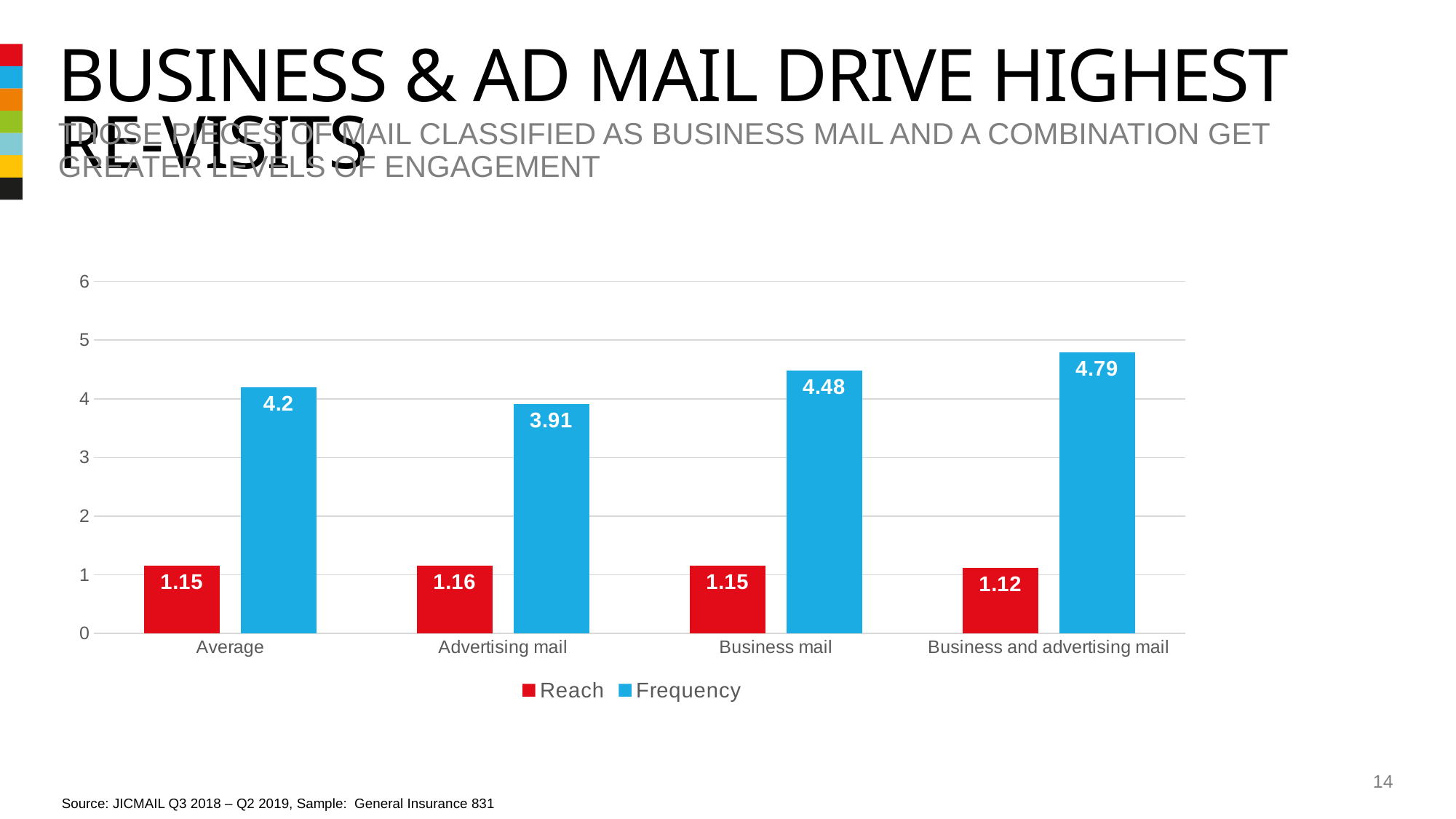
How many categories are shown on the x axis? 4 Which category has the highest Frequency value? Business and advertising mail What is the Reach value for Advertising mail? 1.16 What is the difference between the Frequency values for Business and advertising mail and Business mail? 0.31 What is the Frequency value for Business and advertising mail? 4.79 Which category has the lowest Reach value? Business and advertising mail Which is larger, the Frequency value for Business mail or for Advertising mail? Business mail How many series does the legend list? 2 Which category has the lowest Frequency value? Advertising mail What is the Frequency value for Average? 4.2 Which colour represents the Frequency series? Blue What kind of chart is shown on the slide? Bar chart